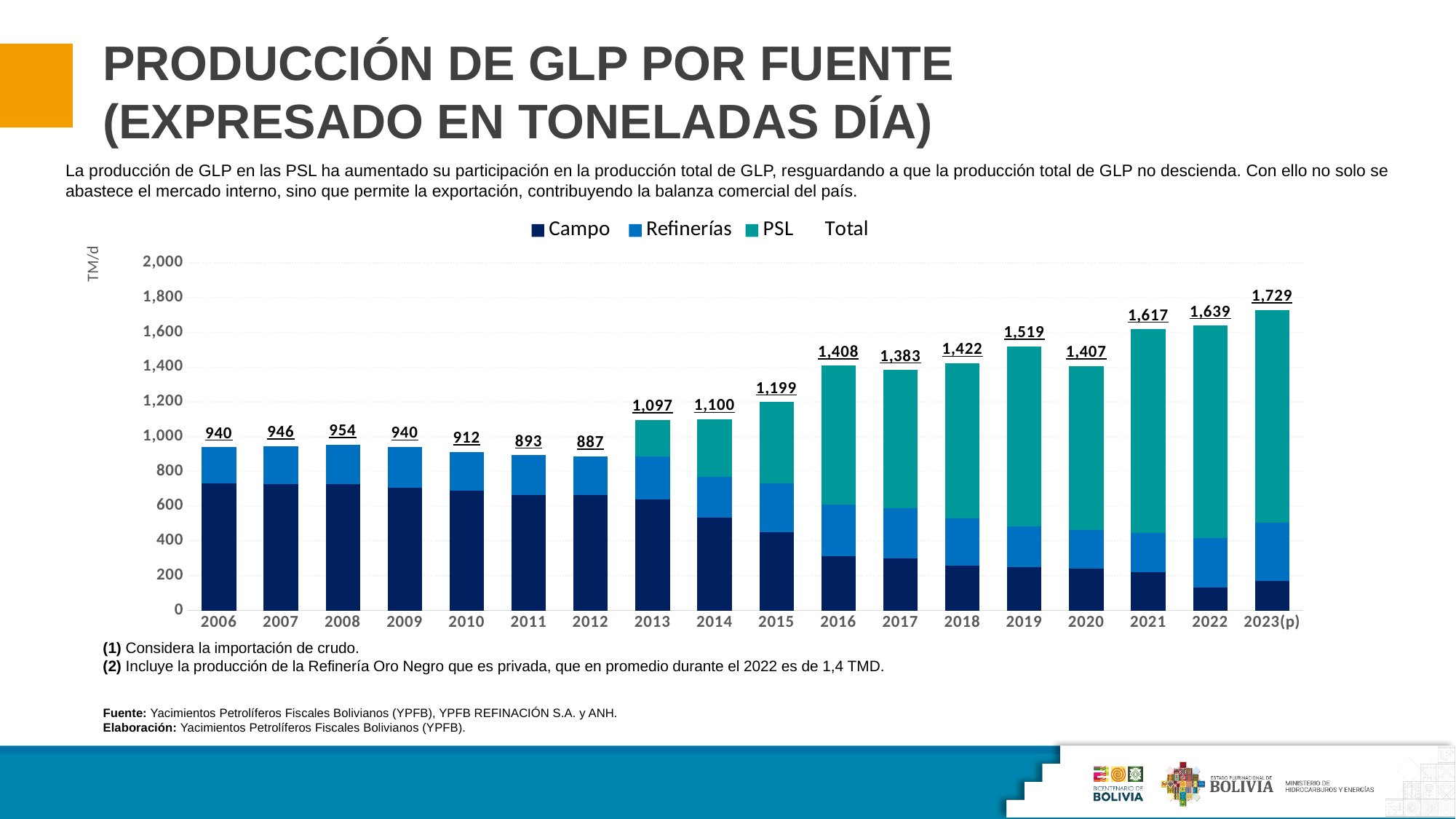
What kind of chart is shown on the slide? Stacked bar chart How many entries does the legend list? 4 Is the Campo value for 2022 greater or less than 200? less What is the total value labelled for 2012? 887 What is the difference between the total for 2023(p) and the total for 2022? 90 Which year has the lowest total GLP production? 2012 What is the total GLP production shown for 2023(p)? 1,729 How many years are shown on the x axis? 18 Which year has the highest total GLP production? 2023(p) Which year has a larger total, 2016 or 2017? 2016 What is the difference between the total for 2019 and the total for 2020? 112 Is the Campo value for 2006 greater or less than 600? greater